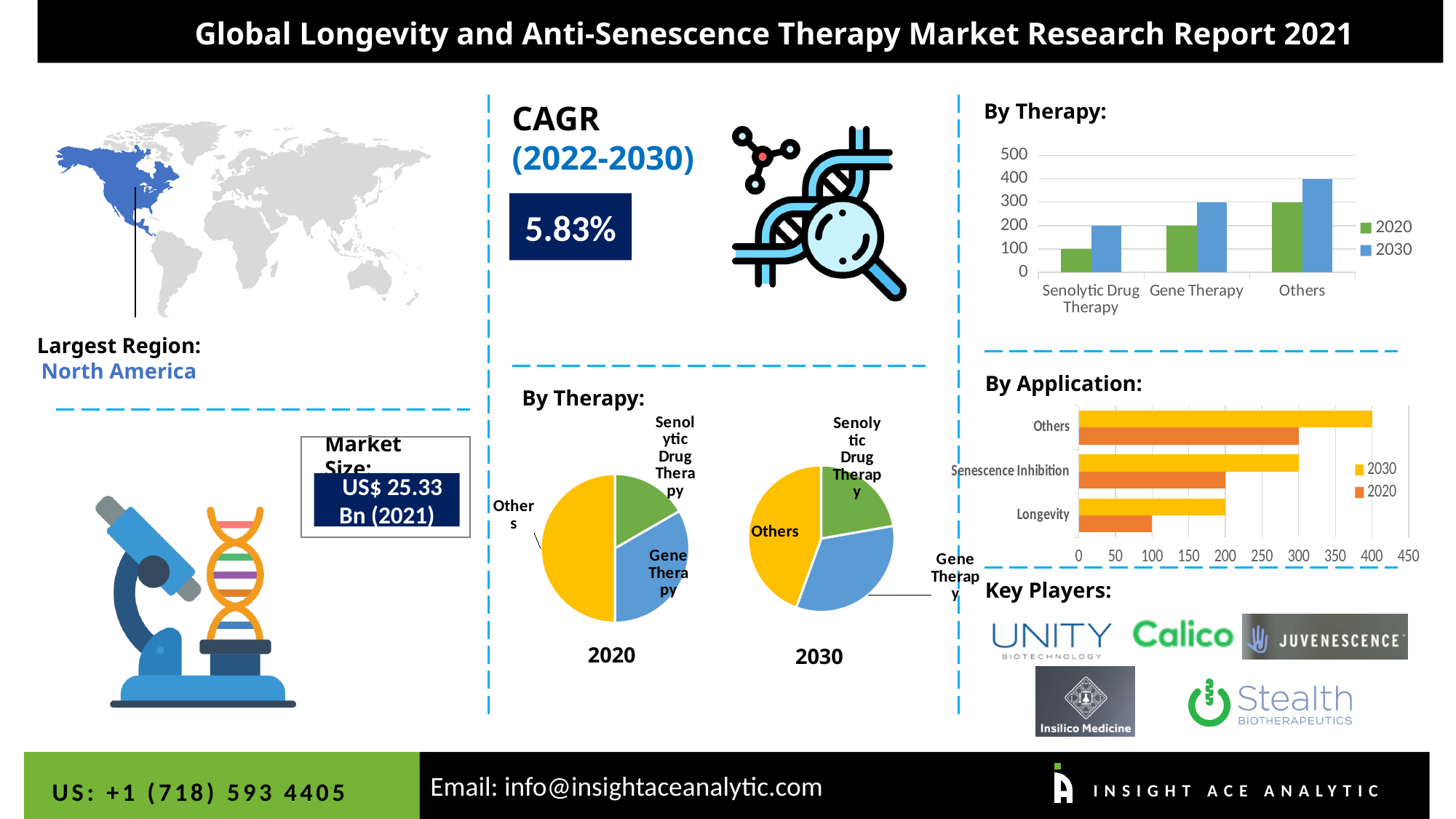
In the 'By Therapy' bar chart, what is the value for Gene Therapy in 2030? 300 In the 'By Therapy' bar chart, which category has the lowest value for 2020? Senolytic Drug Therapy In the 'By Application' chart, which is larger: Senescence Inhibition in 2030 or Others in 2020? They are equal (300) In the 'By Application' chart, what is the value for Longevity in 2020? 100 In the 'By Therapy' bar chart, which category has the highest value for 2030? Others How many series does the legend of the 'By Therapy' bar chart list? 2 What kind of chart is the 'By Application' chart? Bar chart How many slices does the 2020 'By Therapy' pie chart have? 3 In the 'By Therapy' bar chart, what is the difference between the 2030 and 2020 values for Others? 100 In the 'By Application' chart, what is the value for Others in 2030? 400 In the 2030 'By Therapy' pie chart, which slice is the largest? Others In the 'By Therapy' bar chart, what is the value for Senolytic Drug Therapy in 2020? 100